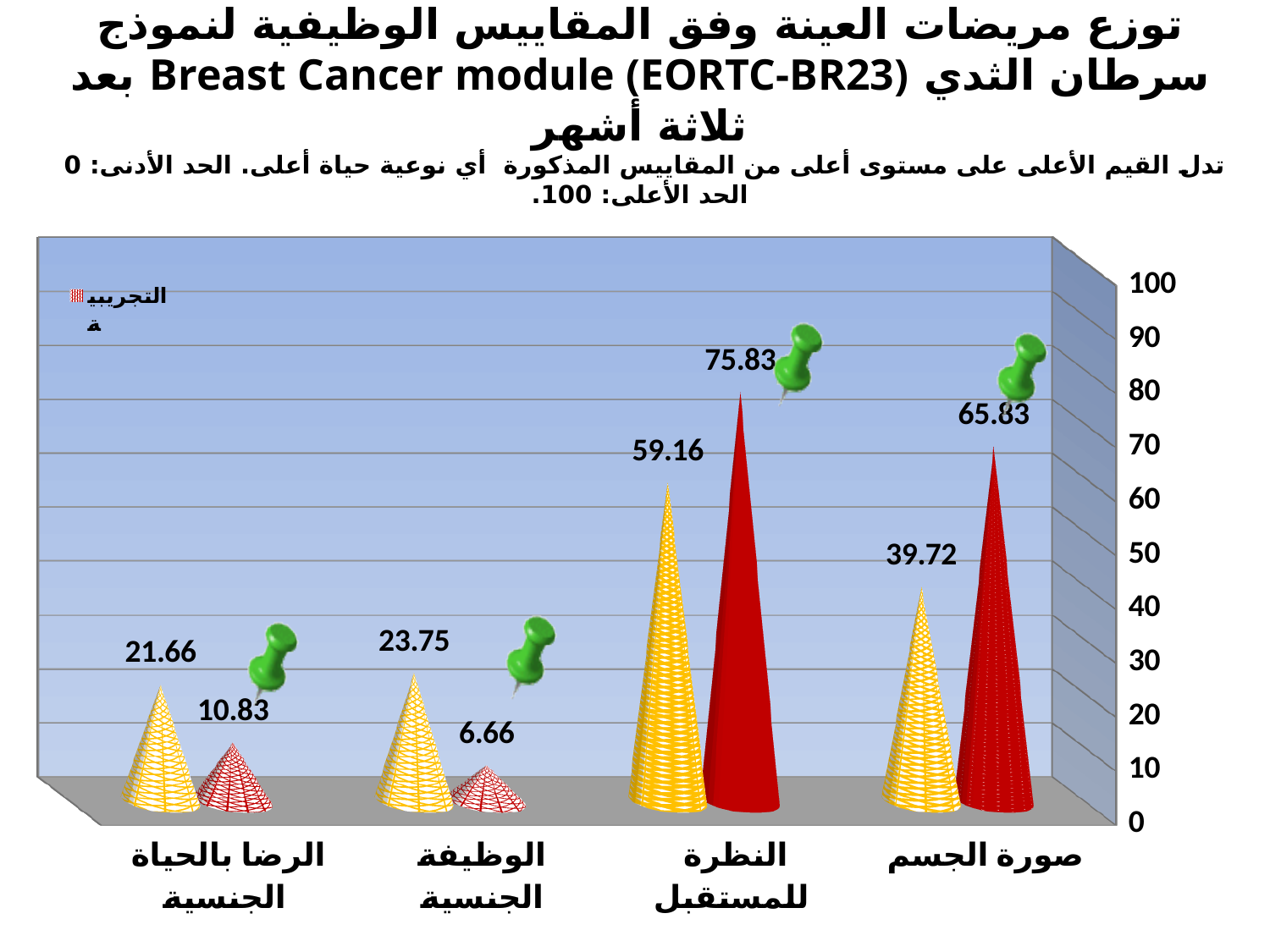
Which category has the lowest yellow cone value? الرضا بالحياة الجنسية What is the value of the yellow cone for النظرة للمستقبل? 59.16 What is the maximum value shown on the vertical axis? 100 Which category has the highest red cone value? النظرة للمستقبل How many categories are shown on the x axis? 4 What type of chart is shown on the slide? bar chart (3D cone) What is the difference between the yellow and red values for الوظيفة الجنسية? 17.09 What is the difference between the red and yellow values for النظرة للمستقبل? 16.67 What is the value of the yellow cone for الرضا بالحياة الجنسية? 21.66 What is the value of the red cone for صورة الجسم? 65.83 For صورة الجسم, which is larger: the yellow cone or the red cone? the red cone What is the value of the red cone for الوظيفة الجنسية? 6.66